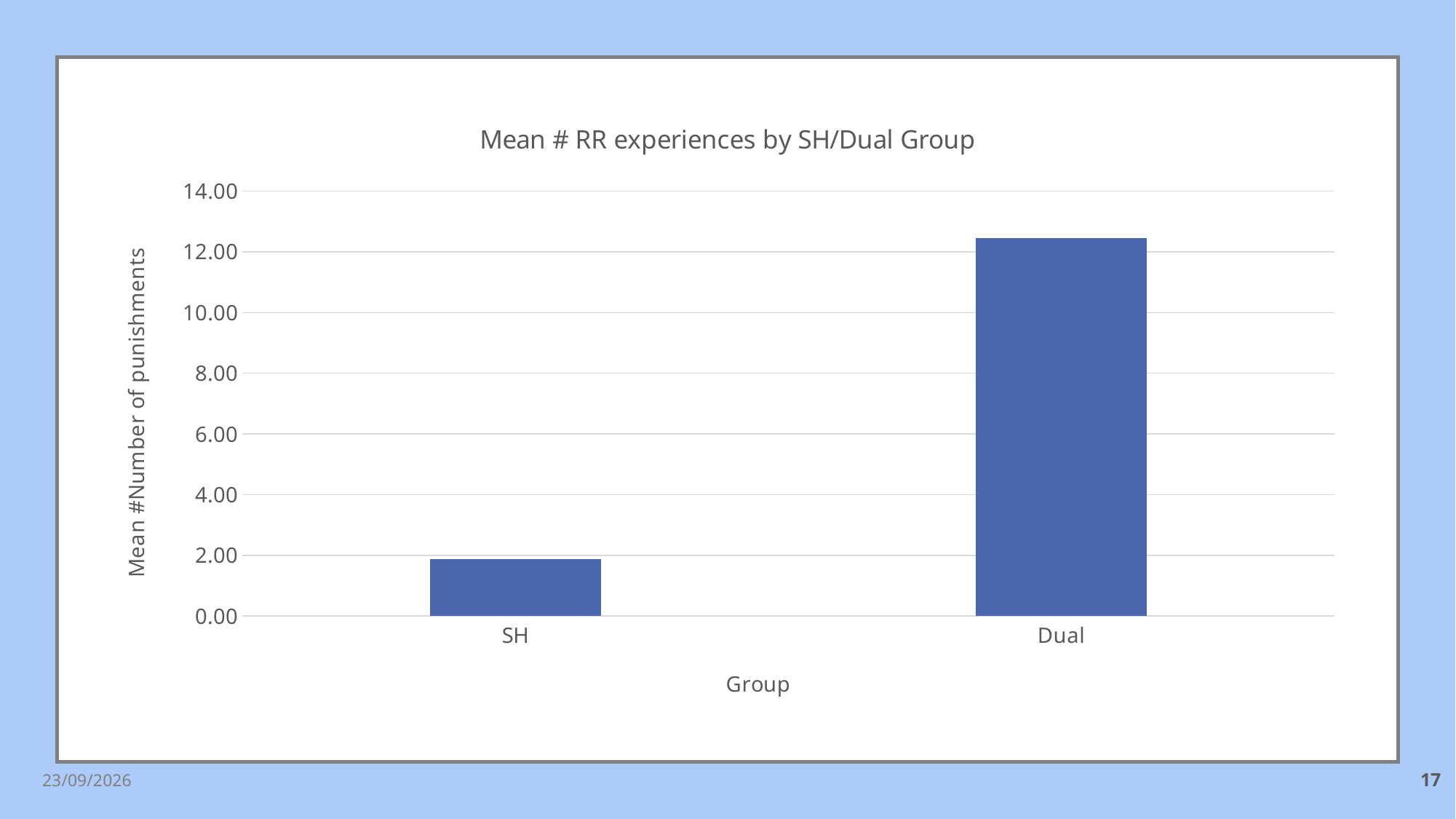
Which group has the lowest mean number of RR experiences? SH Is the value for Dual greater or less than 14.00? less What is the title of the chart? Mean # RR experiences by SH/Dual Group Which group has the larger value, SH or Dual? Dual What kind of chart is shown on the slide? bar chart Do the values rise or fall from SH to Dual along the x axis? rise Is the value for Dual greater or less than 12.00? greater What is the label of the x axis? Group Is the value for SH greater or less than 2.00? less How many groups are plotted on the x axis? 2 Which group has the highest mean number of RR experiences? Dual